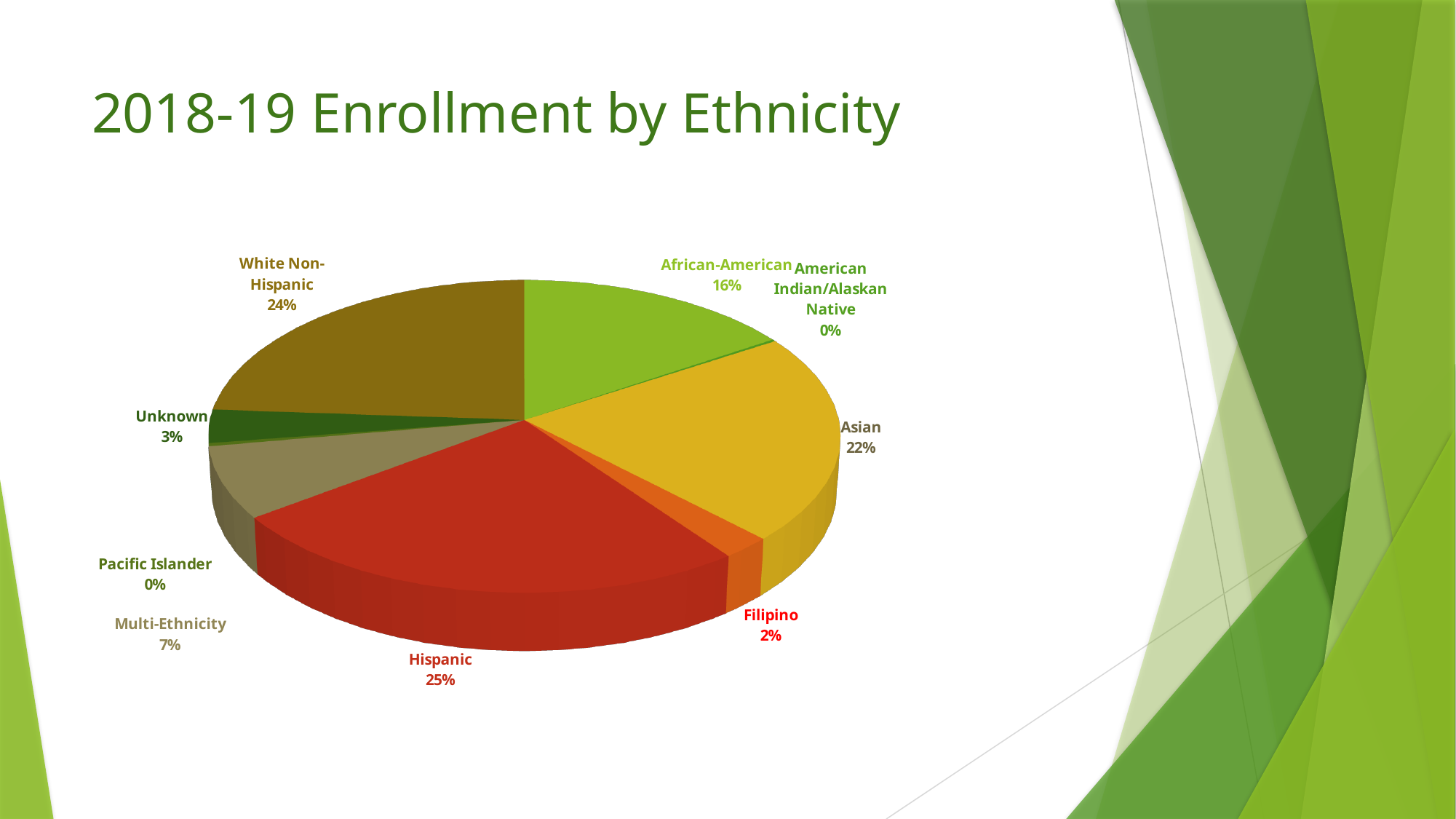
What share of enrollment is Multi-Ethnicity? 7% What share of enrollment is Asian? 22% What is the title of the slide? 2018-19 Enrollment by Ethnicity What share of enrollment is Hispanic? 25% What share of enrollment is African-American? 16% What share of enrollment is Unknown? 3% What is the difference between the White Non-Hispanic share and the Asian share? 2% What kind of chart is shown on the slide? pie chart Which is larger, the Filipino share or the Unknown share? Unknown How many categories are shown in the pie chart? 9 Which two categories each have a 0% share? American Indian/Alaskan Native and Pacific Islander Which ethnicity has the largest share of enrollment? Hispanic